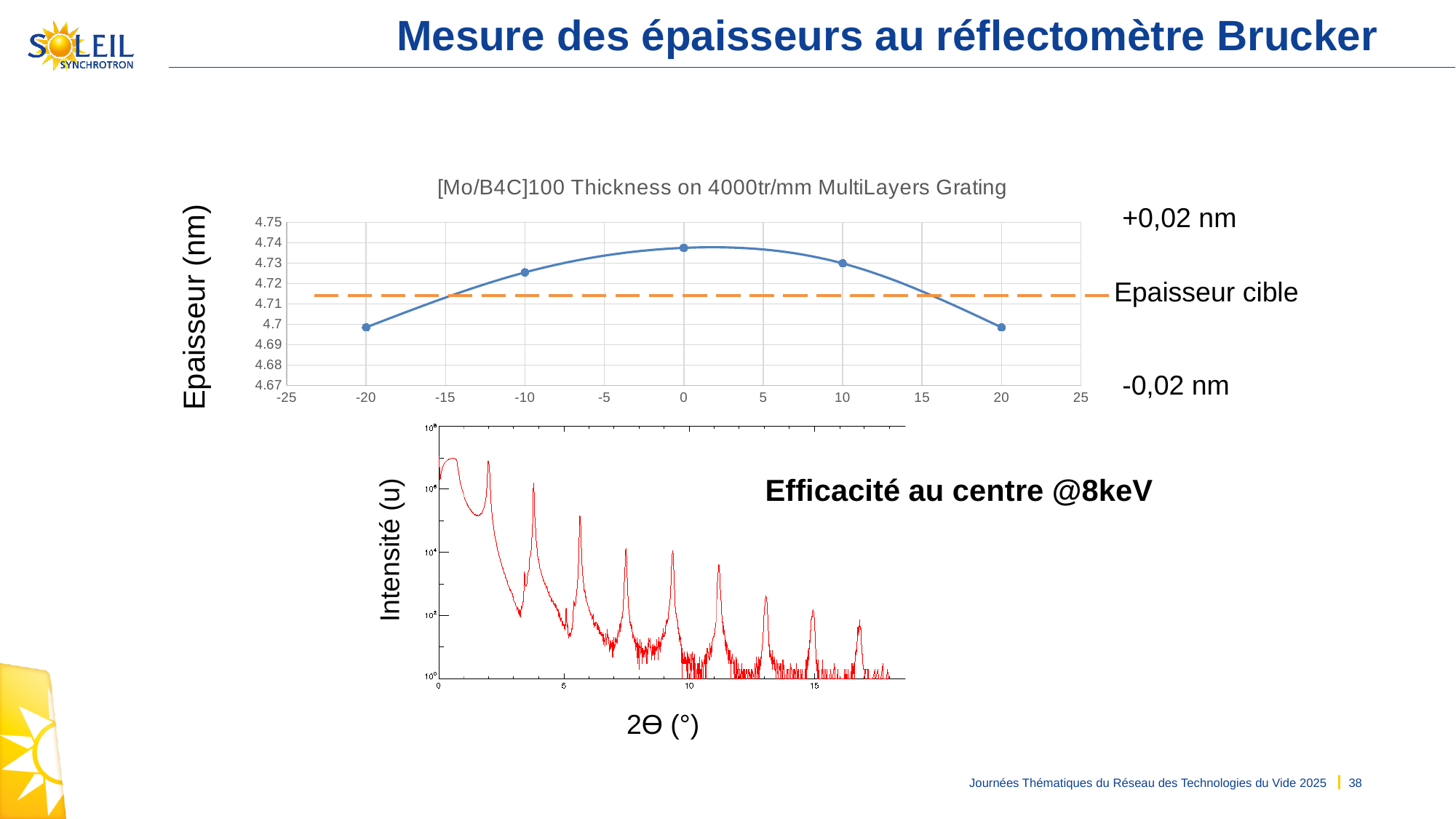
What is the x-axis label of the bottom chart? 2Θ (°) What is the y-axis label of the top chart? Epaisseur (nm) In the top chart, at which x value is the thickness highest? 0 What kind of chart is the top chart titled "[Mo/B4C]100 Thickness on 4000tr/mm MultiLayers Grating"? Line chart In the bottom chart, do the peak intensities rise or fall as 2Θ increases? Fall In the top chart, which has the larger thickness: x = 0 or x = 20? x = 0 In the top chart, is the thickness at x = 10 greater or less than 4.72? greater In the top chart, is the thickness at x = 0 greater or less than 4.73? greater What is the label of the orange dashed line in the top chart? Epaisseur cible In the top chart, how many data points are plotted on the blue line? 5 In the top chart, is the thickness at x = -20 greater or less than 4.71? less In the top chart, how does the thickness change as x goes from -20 to 20? It rises to a maximum near 0, then falls